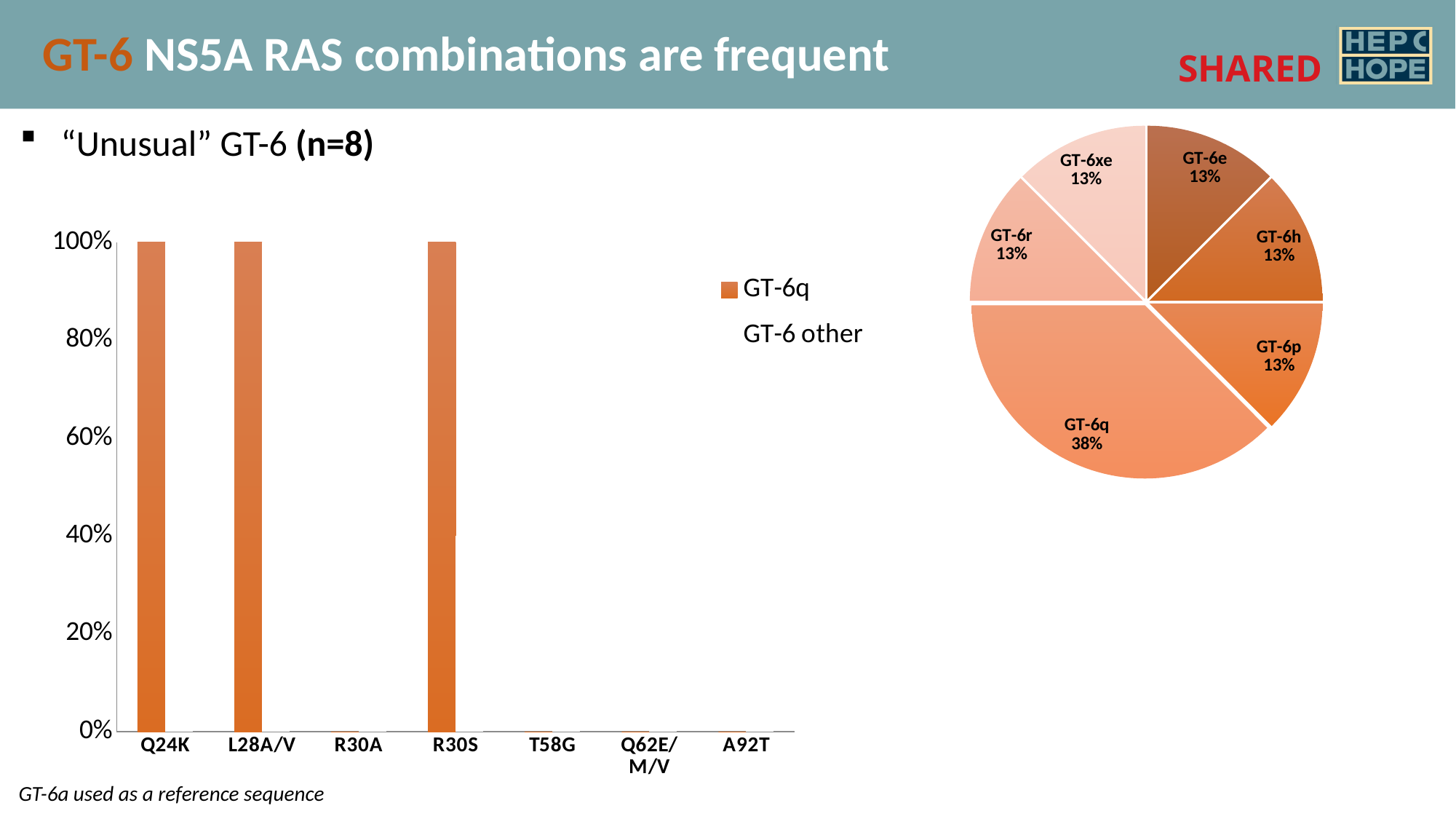
In the bar chart on the left, what is the GT-6q value for R30S? 100% What are the two legend entries of the bar chart on the left? GT-6q and GT-6 other In the pie chart on the right, how much larger is the GT-6q share than the GT-6h share? 25% In the pie chart on the right, what share does GT-6q have? 38% How many categories are shown on the x axis of the bar chart on the left? 7 In the pie chart on the right, what share does GT-6e have? 13% What kind of chart is the chart on the left of the slide? bar chart In the pie chart on the right, which slice is the largest? GT-6q What kind of chart is the chart on the right of the slide? pie chart In the bar chart on the left, what is the GT-6q value for Q24K? 100% How many series does the legend of the bar chart on the left list? 2 How many slices does the pie chart on the right have? 6